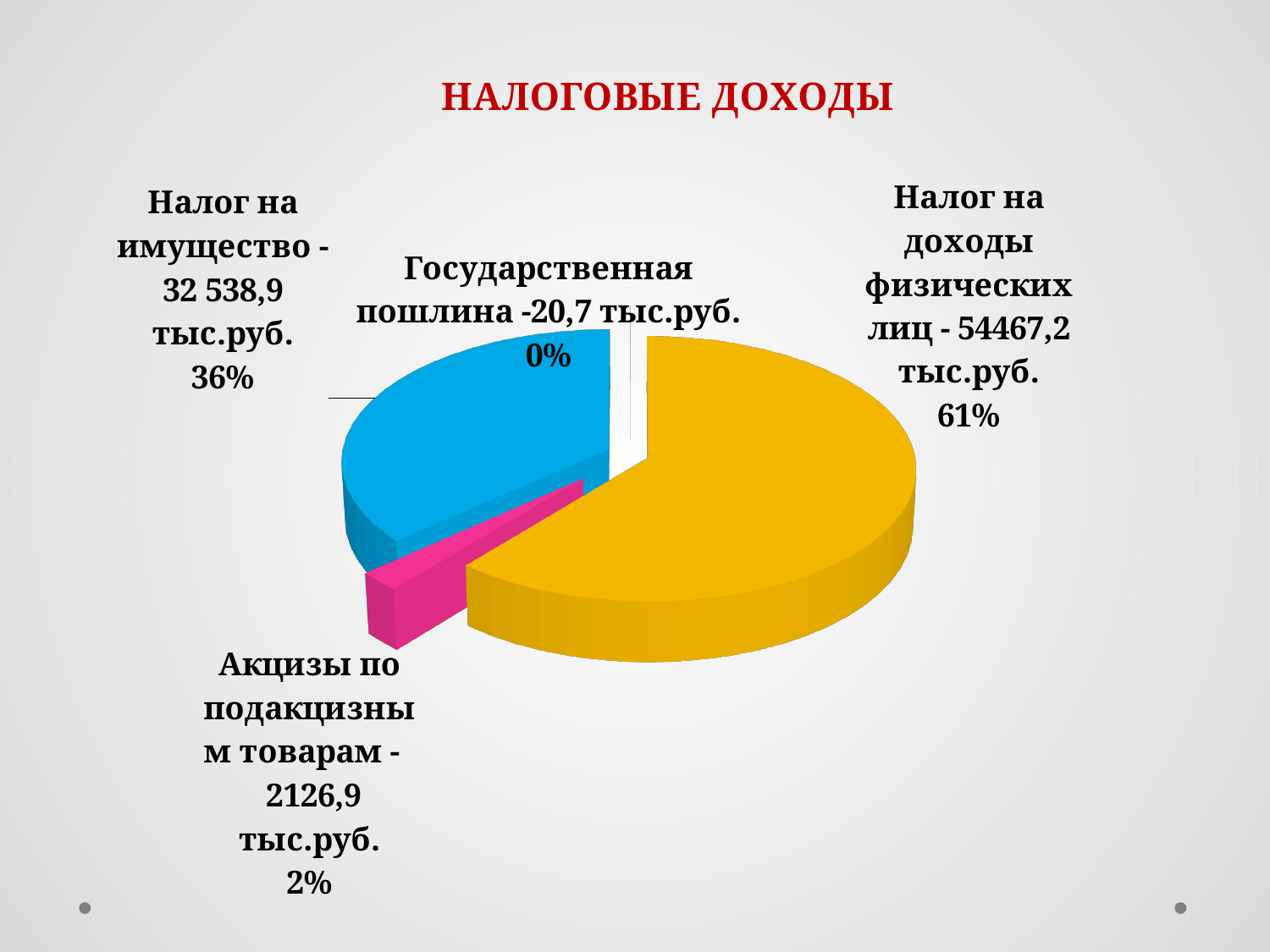
What is the value for Государственная пошлина? 20,7 тыс.руб. What is the value for Налог на доходы физических лиц? 54467,2 тыс.руб. What is the difference between the values for Налог на доходы физических лиц and Налог на имущество? 21928,3 тыс.руб. What type of chart is shown on the slide? Pie chart What share of the pie does Налог на имущество represent? 36% Which category has the largest slice of the pie? Налог на доходы физических лиц What is the value for Налог на имущество? 32 538,9 тыс.руб. Which category has the smallest slice of the pie? Государственная пошлина What is the title of the chart? НАЛОГОВЫЕ ДОХОДЫ What share of the pie does Налог на доходы физических лиц represent? 61% What is the value for Акцизы по подакцизным товарам? 2126,9 тыс.руб. How many slices does the pie chart have? 4